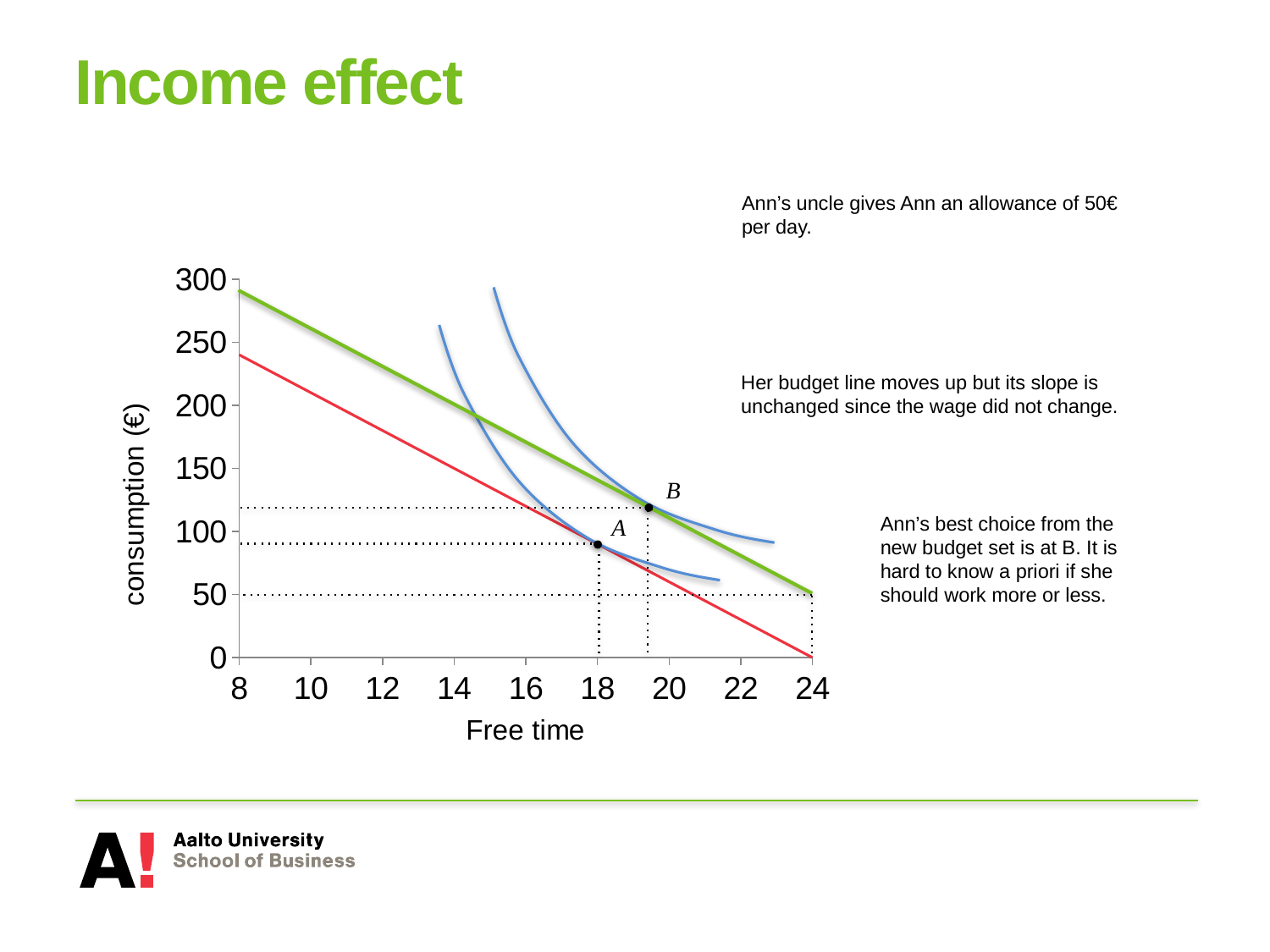
How many labelled points (A, B) are marked on the chart? 2 What kind of chart is shown on the slide? line chart What is the free time value at point A? 18 What is the label of the y axis? consumption (€) What is the title of the slide containing the chart? Income effect Is the free time value at point B greater or less than 18? greater What consumption value does the red budget line reach at 24 hours of free time? 0 Is the consumption value at point A greater or less than 100? less Which point has the higher consumption, A or B? B What consumption value does the green budget line reach at 24 hours of free time? 50 Do the budget lines rise or fall as free time increases along the x axis? fall Is the consumption value at point B greater or less than 100? greater